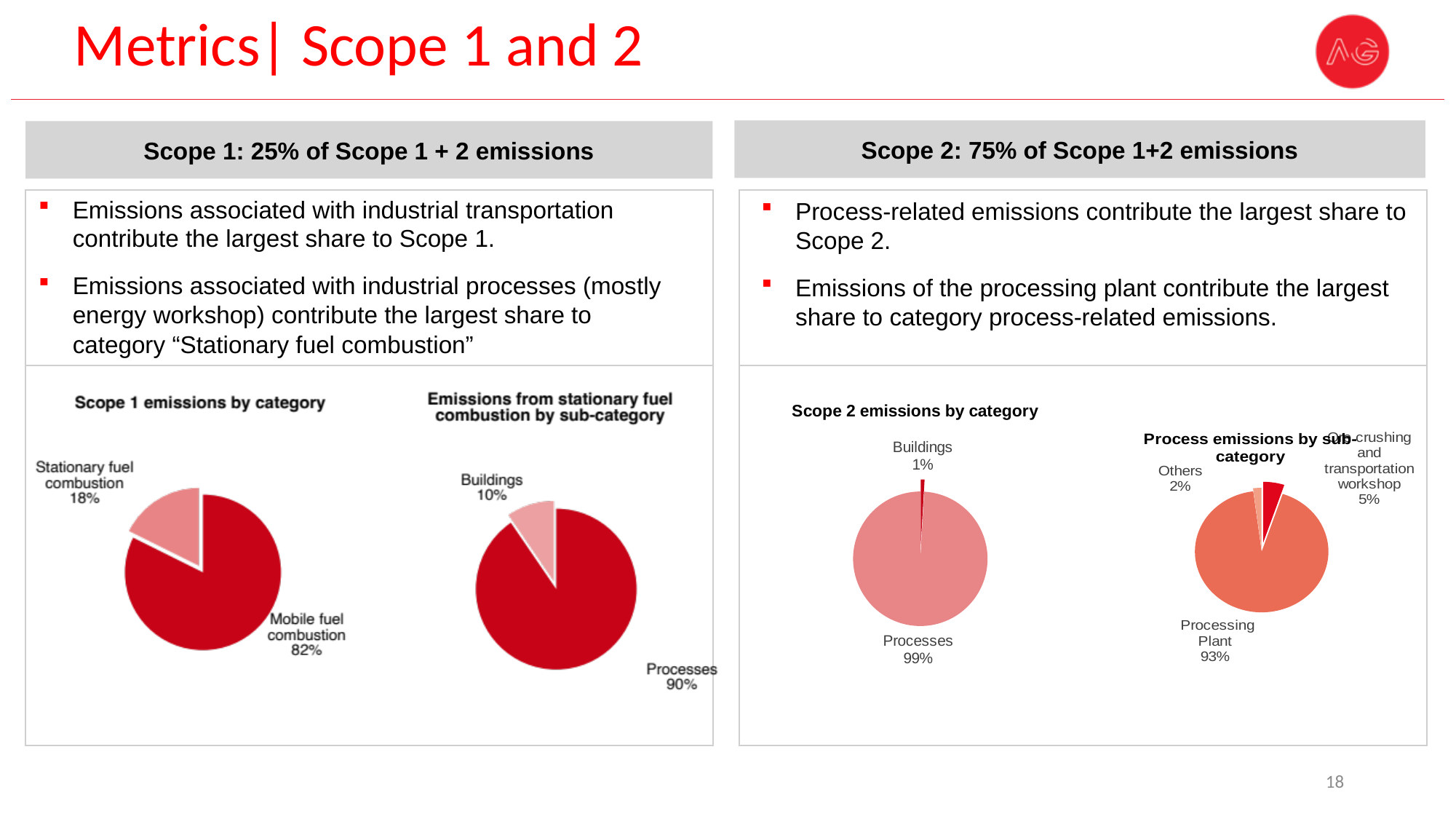
What type of chart is 'Scope 2 emissions by category'? Pie chart How many slices does the 'Process emissions by sub-category' chart have? 3 In the 'Process emissions by sub-category' chart, which slice is the smallest? Others In the 'Scope 1 emissions by category' chart, what share does Stationary fuel combustion have? 18% In the 'Emissions from stationary fuel combustion by sub-category' chart, what share do Buildings have? 10% In the 'Process emissions by sub-category' chart, what share does the Ore crushing and transportation workshop have? 5% In the 'Scope 1 emissions by category' chart, what is the difference in percentage points between Mobile fuel combustion and Stationary fuel combustion? 64 percentage points In the 'Emissions from stationary fuel combustion by sub-category' chart, what share do Processes have? 90% In the 'Scope 1 emissions by category' chart, what share does Mobile fuel combustion have? 82% In the 'Process emissions by sub-category' chart, what share does the Processing Plant have? 93% In the 'Scope 2 emissions by category' chart, what share do Buildings have? 1% In the 'Scope 2 emissions by category' chart, which category is the largest? Processes